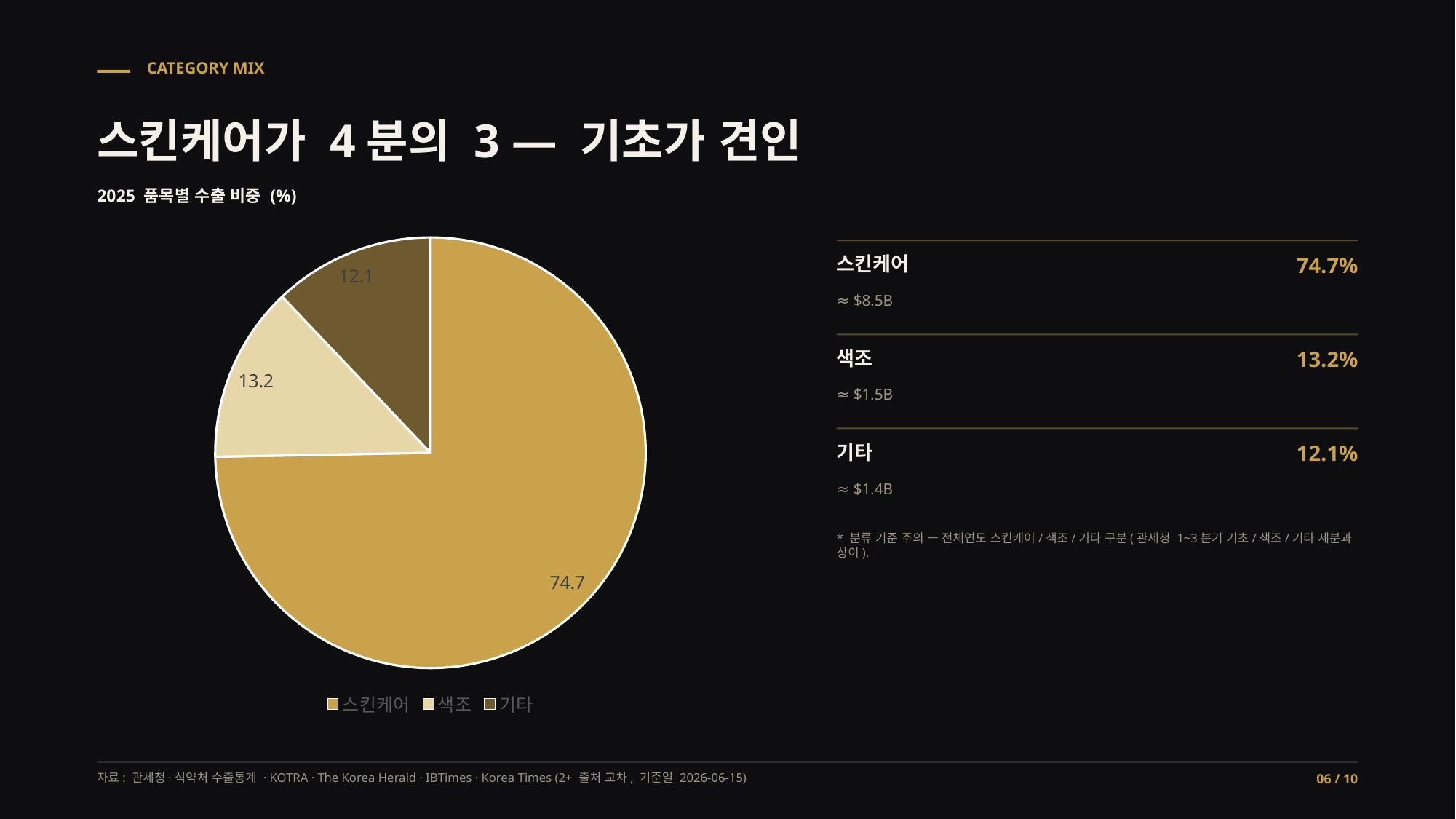
How many entries does the legend list? 3 What is the difference between the values for 색조 and 기타? 1.1 Which category has the largest slice of the pie? 스킨케어 What is the difference between the values for 스킨케어 and 색조? 61.5 What is the value shown for 기타 in the pie chart? 12.1 What is the value shown for 스킨케어 in the pie chart? 74.7 What is the subtitle of the chart shown above the pie? 2025 품목별 수출 비중 (%) How many slices does the pie chart have? 3 What is the value shown for 색조 in the pie chart? 13.2 What kind of chart is shown on the slide? pie chart Which category has the smallest slice of the pie? 기타 Which is larger, the slice for 색조 or the slice for 기타? 색조